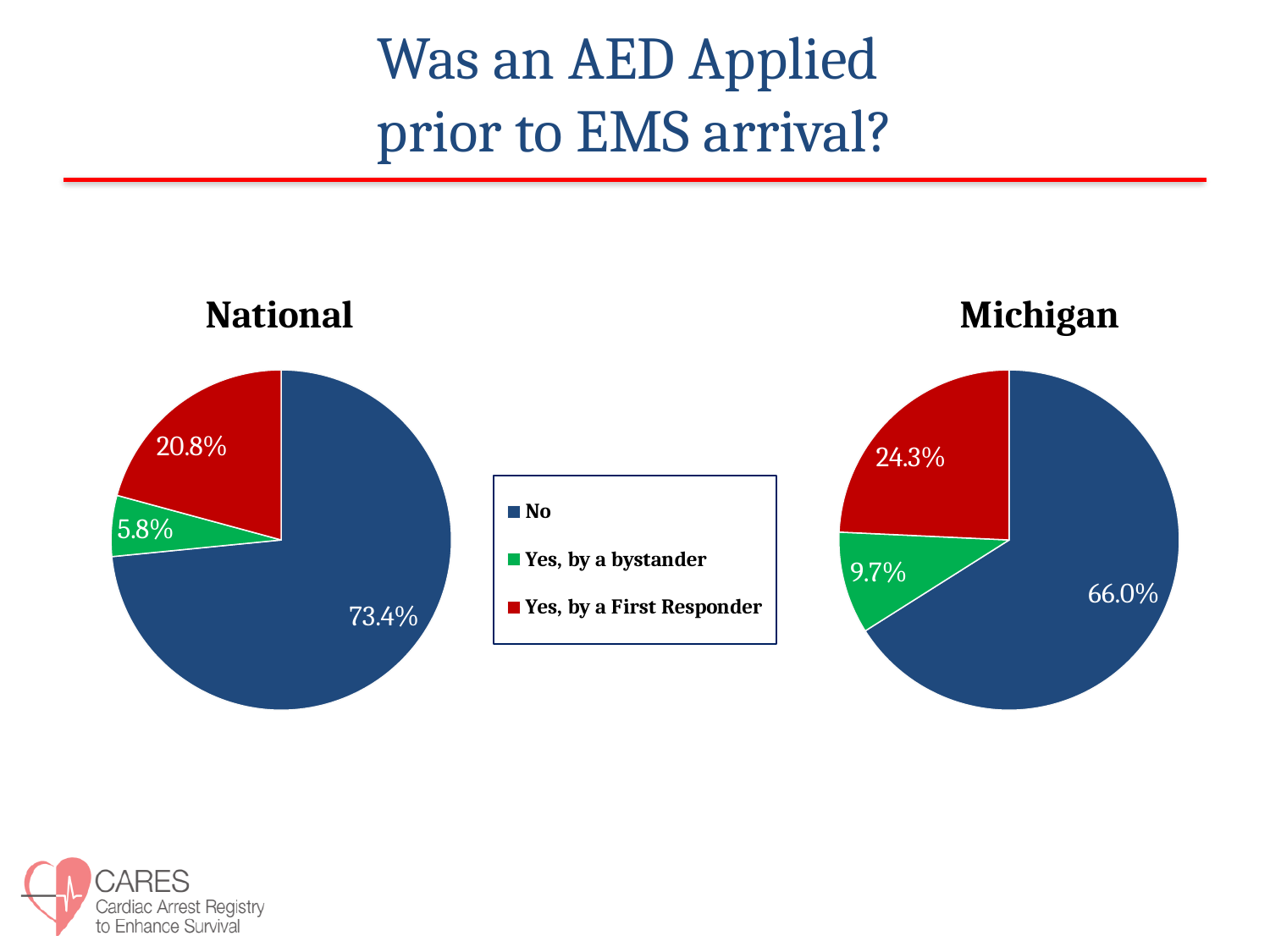
In the National pie chart, what share of cases had no AED applied prior to EMS arrival? 73.4% What is the difference between the 'No' share in the National chart and the 'No' share in the Michigan chart? 7.4% In the National pie chart, which category has the smallest slice? Yes, by a bystander In the Michigan pie chart, what share of cases had an AED applied by a bystander? 9.7% What type of chart is used to show the National data? Pie chart In the Michigan pie chart, which category has the largest slice? No In the Michigan pie chart, what is the combined share of cases where an AED was applied (by a bystander or a First Responder)? 34.0% In the National pie chart, what share of cases had an AED applied by a bystander? 5.8% Which colour represents 'Yes, by a bystander' in the legend? Green Which chart shows a larger share for 'Yes, by a First Responder', National or Michigan? Michigan How many categories does the legend list? 3 In the Michigan pie chart, what share of cases had an AED applied by a First Responder? 24.3%